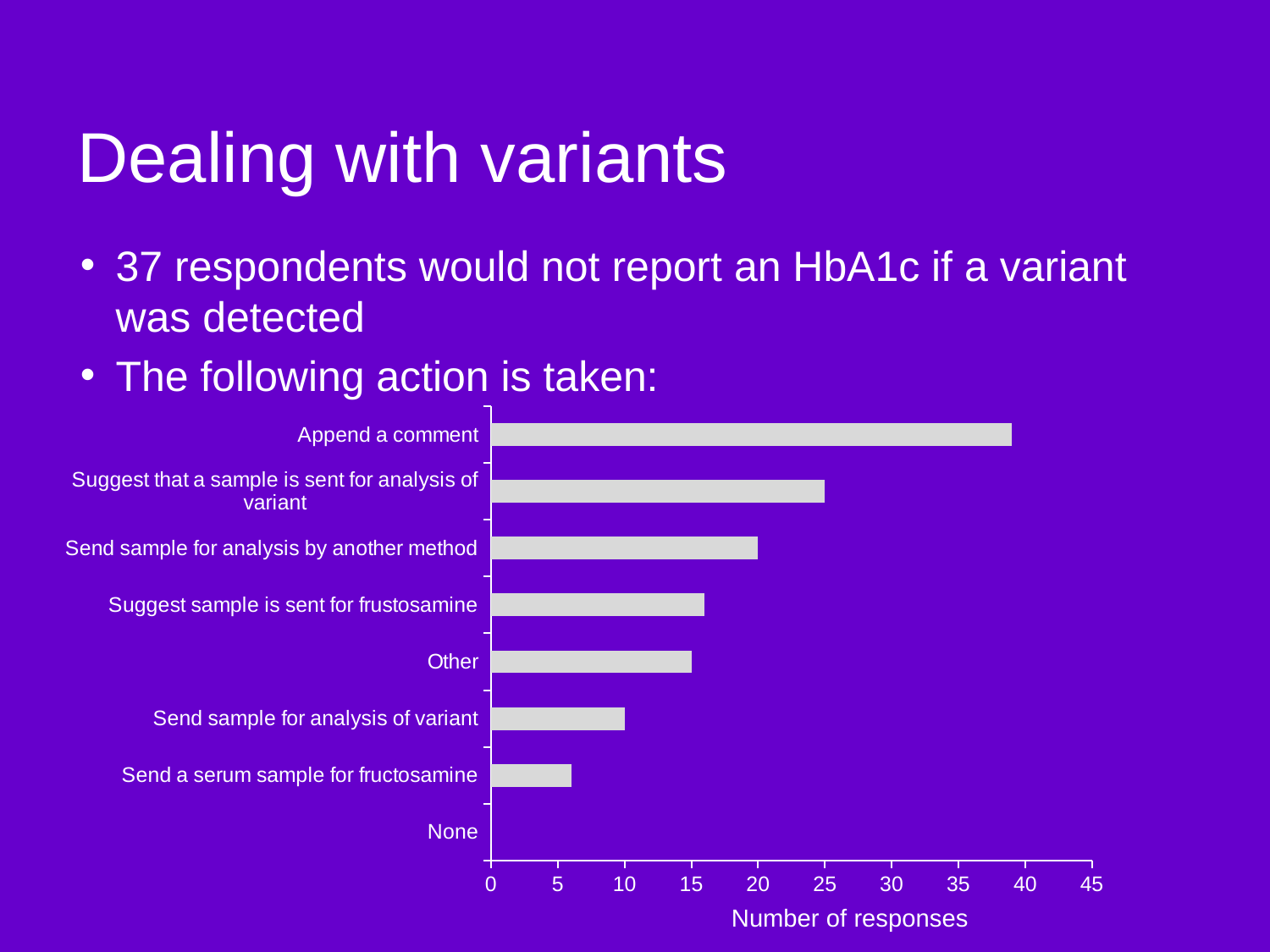
Which category has the highest number of responses? Append a comment Which category has the lowest number of responses? None Is the value for Send a serum sample for fructosamine greater or less than 10? less What is the number of responses for None? 0 Is the value for Suggest sample is sent for frustosamine greater or less than 20? less Which has more responses, Send sample for analysis by another method or Other? Send sample for analysis by another method What is the label of the horizontal axis? Number of responses Is the value for Append a comment greater or less than 35? greater Which has more responses, Send sample for analysis of variant or Suggest that a sample is sent for analysis of variant? Suggest that a sample is sent for analysis of variant What kind of chart is shown on the slide? bar chart How many categories are shown on the chart? 8